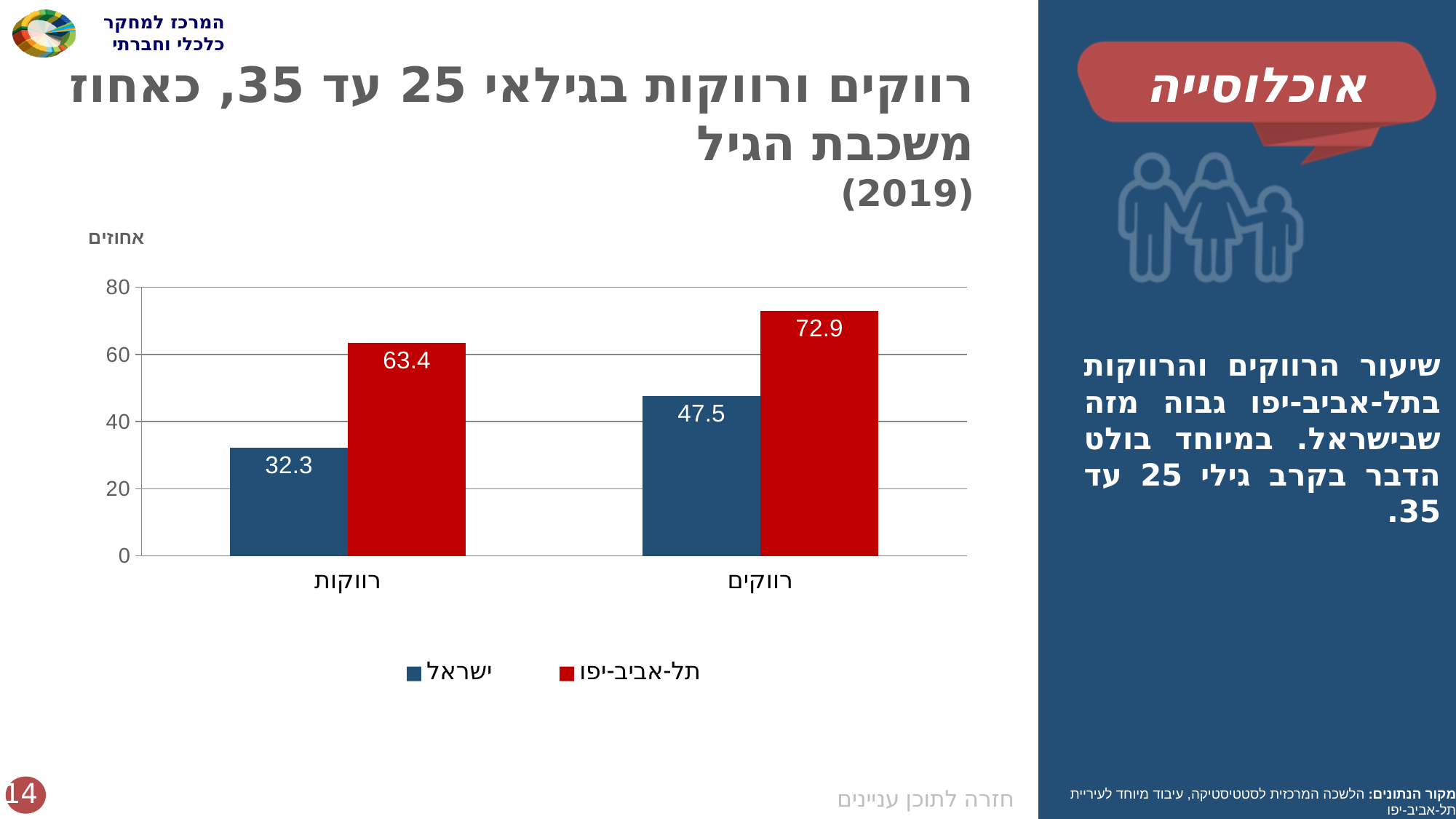
What is the value for תל-אביב-יפו in the רווקות category? 63.4 What is the value for ישראל in the רווקים category? 47.5 What kind of chart is shown on the slide? bar chart Which bar has the highest value on the chart? תל-אביב-יפו, רווקים What is the difference between the תל-אביב-יפו and ישראל values in the רווקות category? 31.1 How many series does the legend list? 2 What is the difference between the תל-אביב-יפו and ישראל values in the רווקים category? 25.4 How many categories are shown on the x axis? 2 What is the value for תל-אביב-יפו in the רווקים category? 72.9 Which is larger in the רווקים category: ישראל or תל-אביב-יפו? תל-אביב-יפו Which bar has the lowest value on the chart? ישראל, רווקות What is the value for ישראל in the רווקות category? 32.3